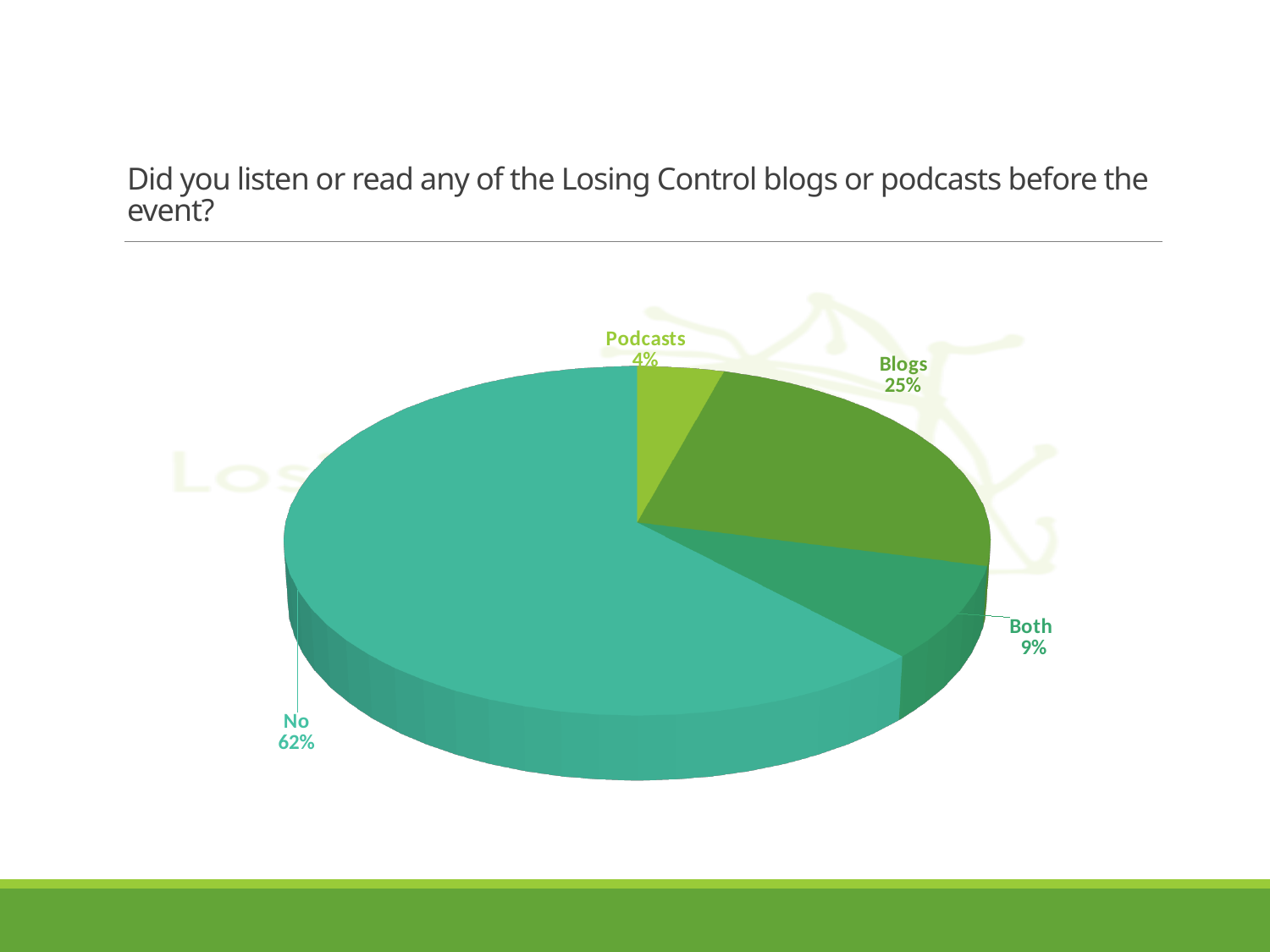
What question does the slide title ask? Did you listen or read any of the Losing Control blogs or podcasts before the event? What is the value for "Both"? 9% What share of the pie is labelled "Blogs"? 25% What kind of chart is shown on the slide? Pie chart Which category has the smallest slice of the pie? Podcasts Which category has the largest slice of the pie? No What is the difference in percentage points between "No" and "Blogs"? 37 Which is larger, the share for "Both" or the share for "Podcasts"? Both How many slices does the pie chart have? 4 What is the combined share of "Blogs", "Podcasts" and "Both"? 38% What is the value for "Podcasts"? 4% What percentage of respondents answered "No"? 62%